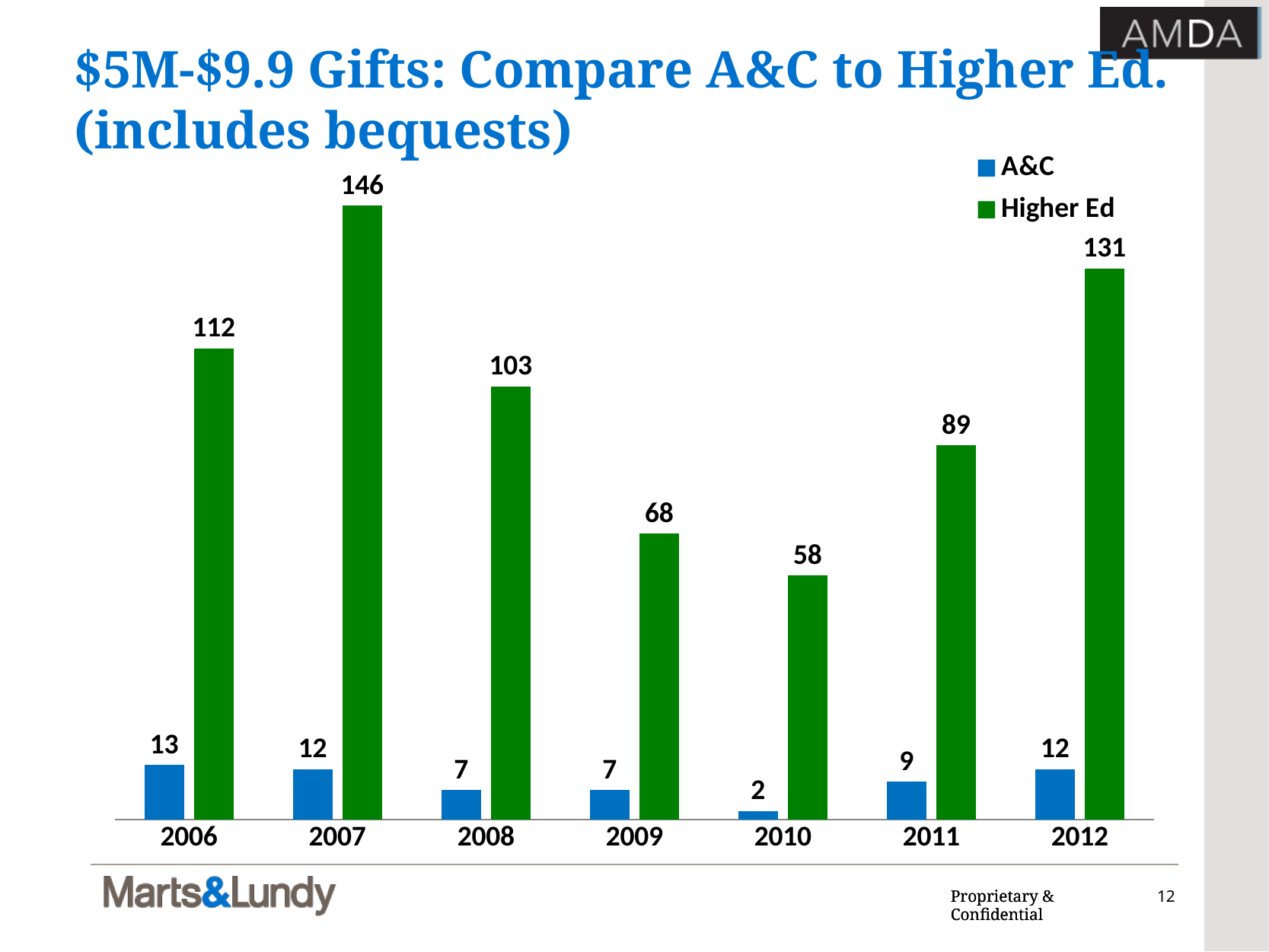
Which year has the lowest A&C value? 2010 Which colour represents the Higher Ed series? Green How many years are shown on the x axis? 7 Which is larger, the Higher Ed value for 2009 or for 2010? 2009 How many series does the legend list? 2 What kind of chart is shown on the slide? Bar chart Which year has the highest Higher Ed value? 2007 Does the Higher Ed value rise or fall from 2010 to 2012? Rise What is the difference between the Higher Ed and A&C values in 2006? 99 What is the Higher Ed value for 2007? 146 What is the Higher Ed value for 2012? 131 What is the A&C value for 2010? 2